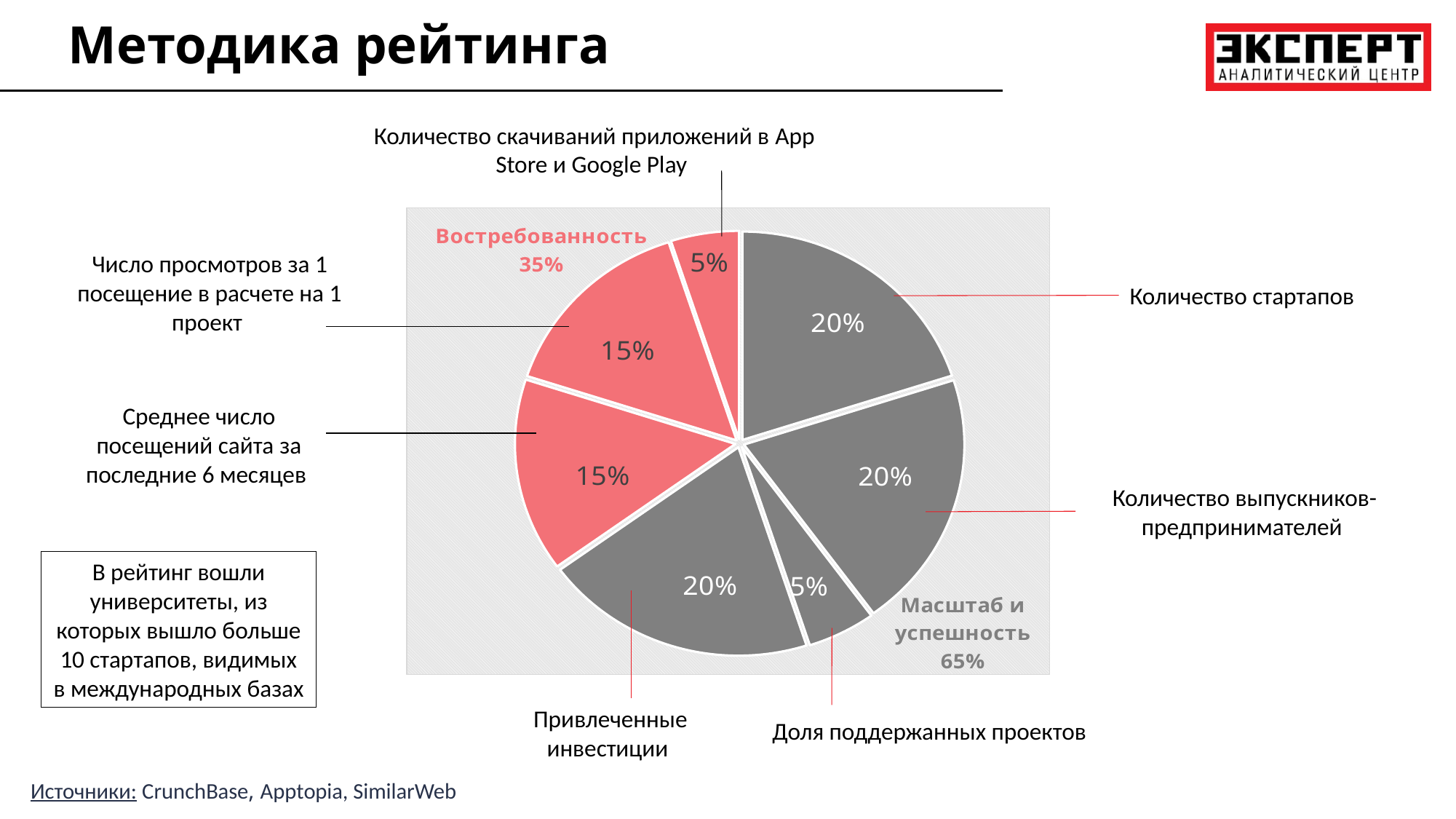
What share of the pie is "Доля поддержанных проектов"? 5% What total share is shown for the "Востребованность" group of slices? 35% What kind of chart is shown on the slide? pie chart What is the difference between the share for "Количество выпускников-предпринимателей" and the share for "Доля поддержанных проектов"? 15% How many slices does the pie chart have? 7 What share of the pie is "Среднее число посещений сайта за последние 6 месяцев"? 15% What total share is shown for the "Масштаб и успешность" group of slices? 65% What colour are the slices belonging to the "Востребованность" group? red (pink) What share of the pie is "Привлеченные инвестиции"? 20% Which is larger: the slice for "Число просмотров за 1 посещение в расчете на 1 проект" or the slice for "Количество выпускников-предпринимателей"? Количество выпускников-предпринимателей